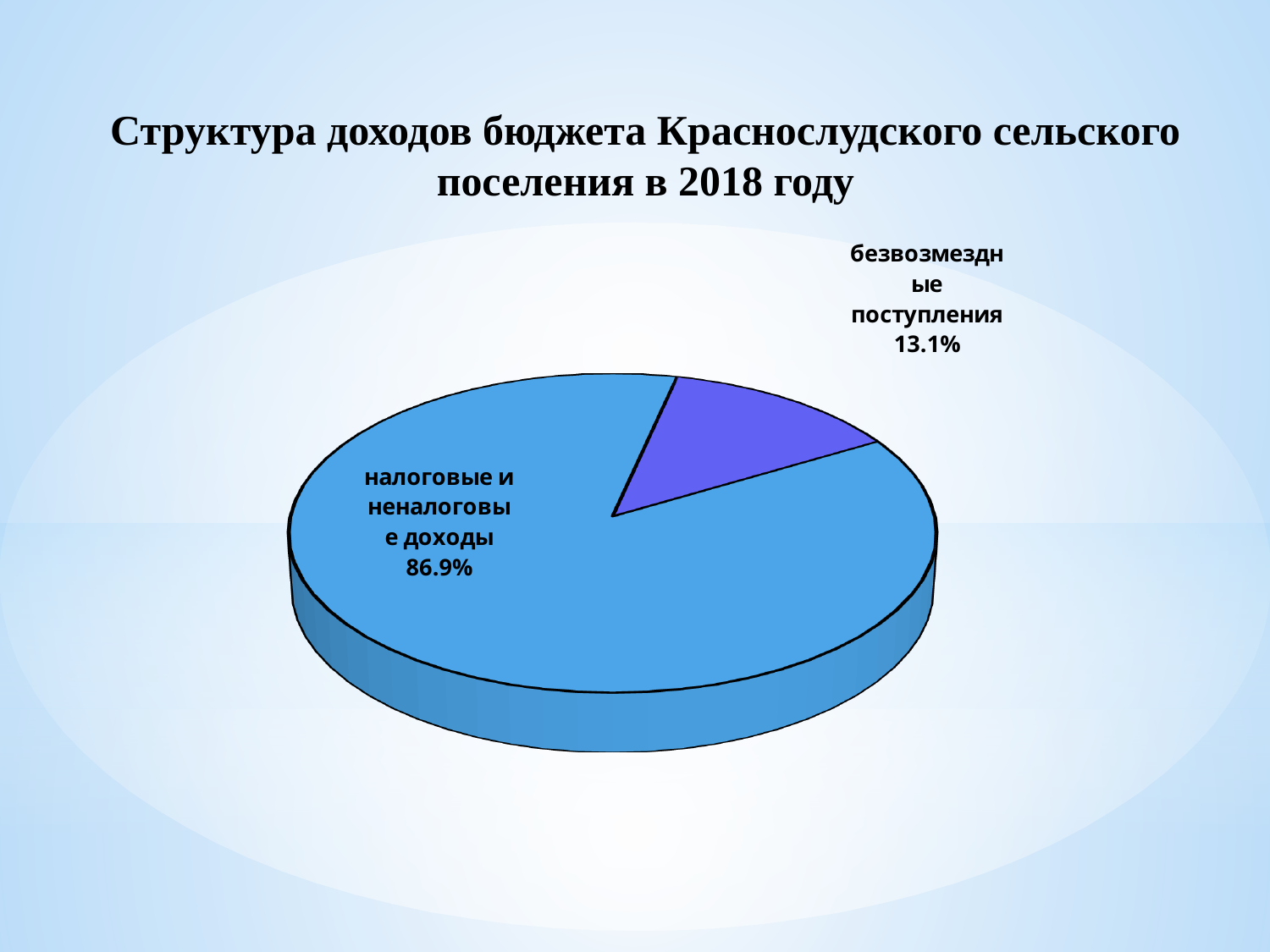
Which slice of the pie is the largest? налоговые и неналоговые доходы How many slices does the pie chart have? 2 What is the total of the two slice percentages shown on the pie chart? 100% What is the difference in percentage points between the "налоговые и неналоговые доходы" slice and the "безвозмездные поступления" slice? 73.8 Which is larger: the share for "налоговые и неналоговые доходы" or the share for "безвозмездные поступления"? налоговые и неналоговые доходы What share of the pie is labelled "безвозмездные поступления"? 13.1% What share of the pie is labelled "налоговые и неналоговые доходы"? 86.9% Which slice of the pie is the smallest? безвозмездные поступления What is the title of the slide containing the pie chart? Структура доходов бюджета Краснослудского сельского поселения в 2018 году What kind of chart is shown on the slide? pie chart What colour is the "безвозмездные поступления" slice? purple